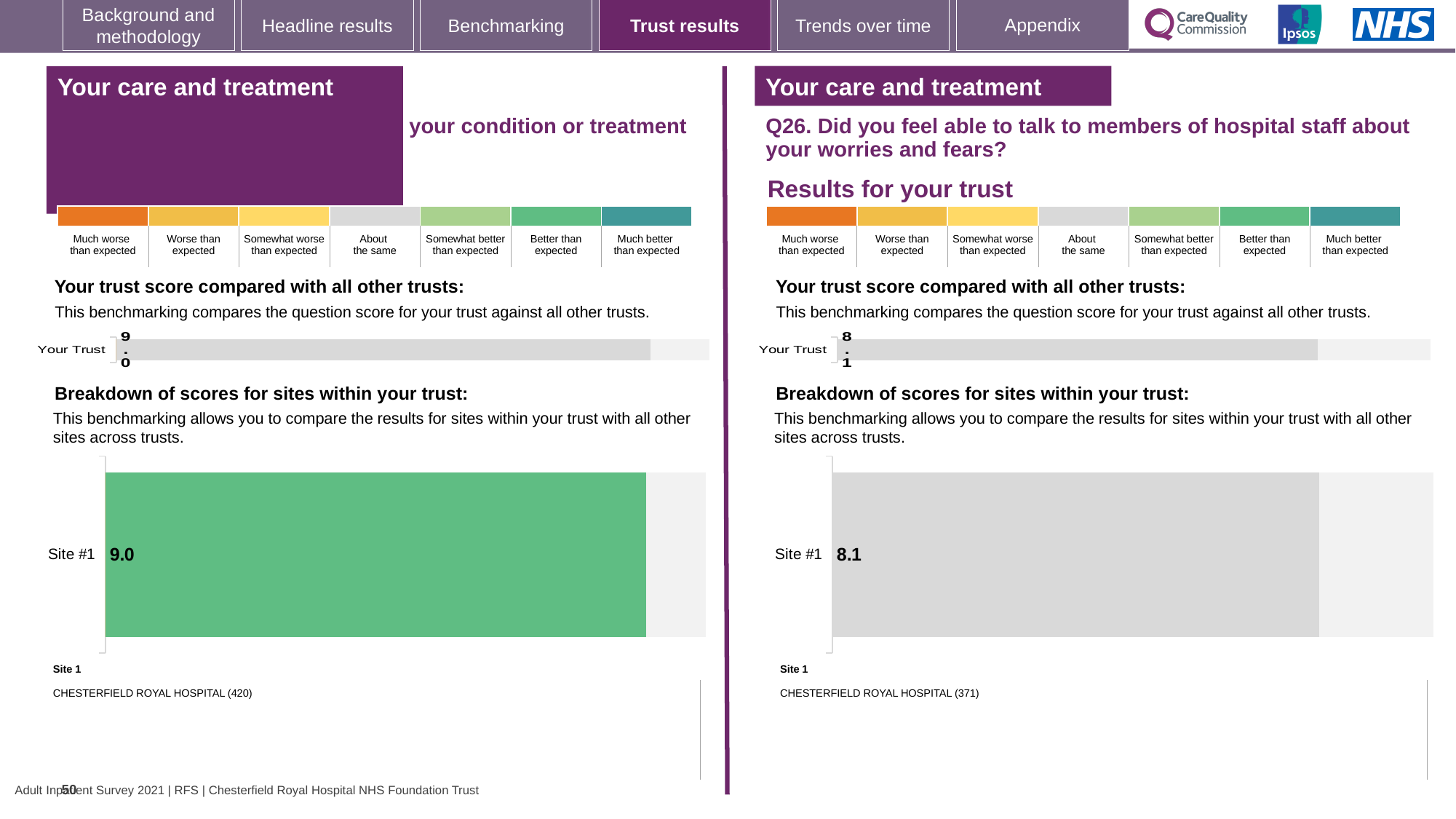
In the 'Breakdown of scores for sites within your trust' chart on the right half of the slide (Q26), what is the score for Site #1? 8.1 In the 'Breakdown of scores for sites within your trust' chart on the left half of the slide, what is the score for Site #1? 9.0 What colour is the Site #1 bar in the breakdown chart on the right half of the slide (Q26)? Grey What is the difference between the Site #1 score in the left-hand breakdown chart (9.0) and the Site #1 score in the right-hand Q26 breakdown chart (8.1)? 0.9 Which is larger: the Site #1 score in the left-hand breakdown chart or the Site #1 score in the right-hand (Q26) breakdown chart? Left-hand chart (9.0) What kind of chart is used to show the Site #1 score in the breakdown section on the left half of the slide? Bar chart Which site name is listed under 'Site 1' for the chart on the left half of the slide? CHESTERFIELD ROYAL HOSPITAL (420) On the left half of the slide, what is the score shown for Your Trust in the 'Your trust score compared with all other trusts' chart? 9.0 Which site name is listed under 'Site 1' for the Q26 chart on the right half of the slide? CHESTERFIELD ROYAL HOSPITAL (371) On the right half of the slide (Q26), what is the score shown for Your Trust in the 'Your trust score compared with all other trusts' chart? 8.1 What colour is the Site #1 bar in the breakdown chart on the left half of the slide? Green How many sites are shown in the 'Breakdown of scores for sites within your trust' chart on the right half of the slide (Q26)? 1